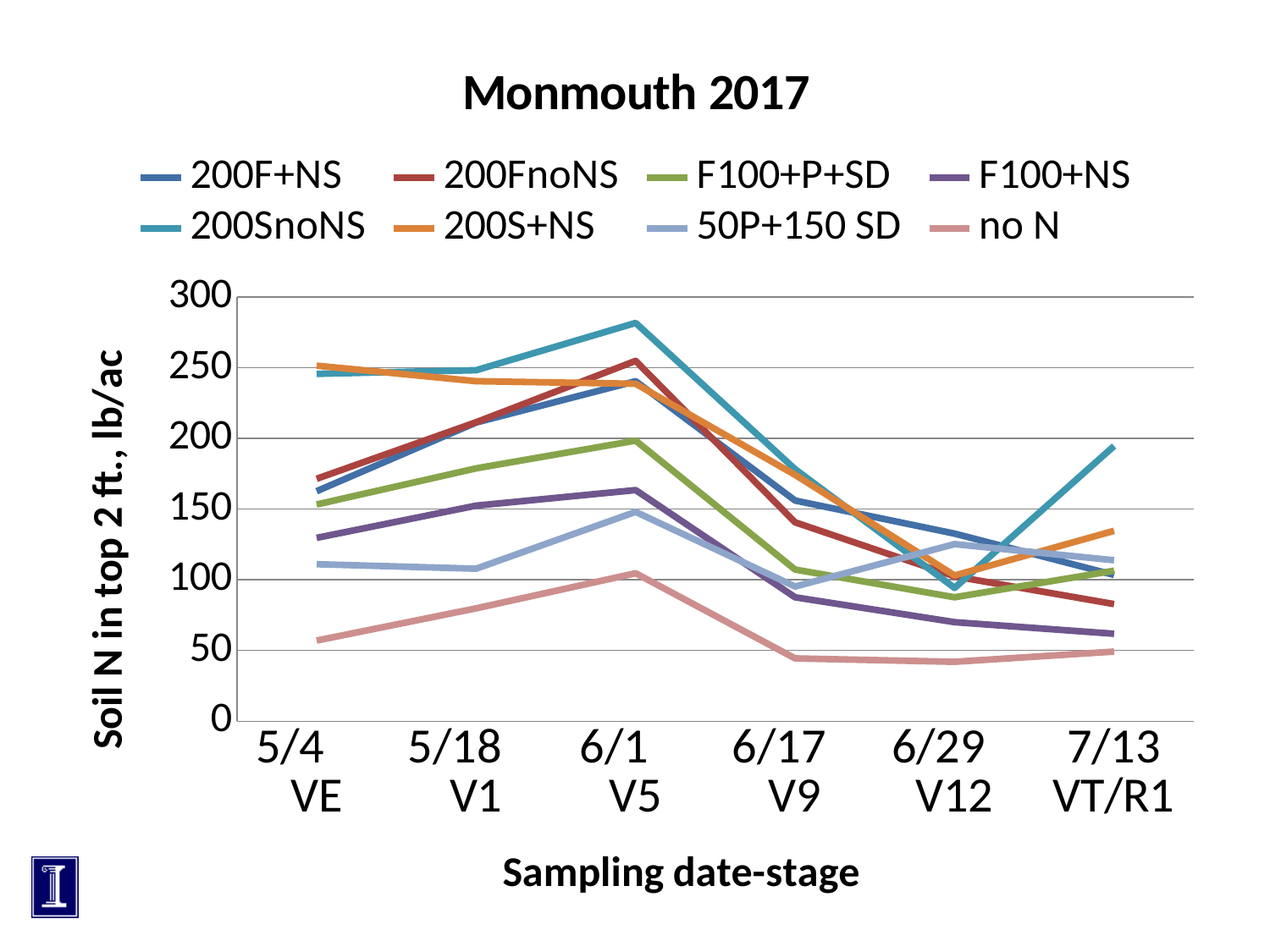
Which series has the highest soil N value at 6/1 V5? 200SnoNS What is the title of the y axis? Soil N in top 2 ft., lb/ac Does the no N series rise or fall from 6/1 V5 to 6/17 V9? fall What kind of chart is shown on the slide? line chart Which series has the highest soil N value at 7/13 VT/R1? 200SnoNS At 7/13 VT/R1, which is larger: the value for 200S+NS or the value for 200FnoNS? 200S+NS Is the value for no N at 5/4 VE greater or less than 100? less Is the value for F100+NS at 7/13 VT/R1 greater or less than 100? less How many series does the legend list? 8 Is the value for 200SnoNS at 6/1 V5 greater or less than 250? greater How many sampling date-stages are plotted along the x axis? 6 Which series has the lowest soil N value at 6/1 V5? no N